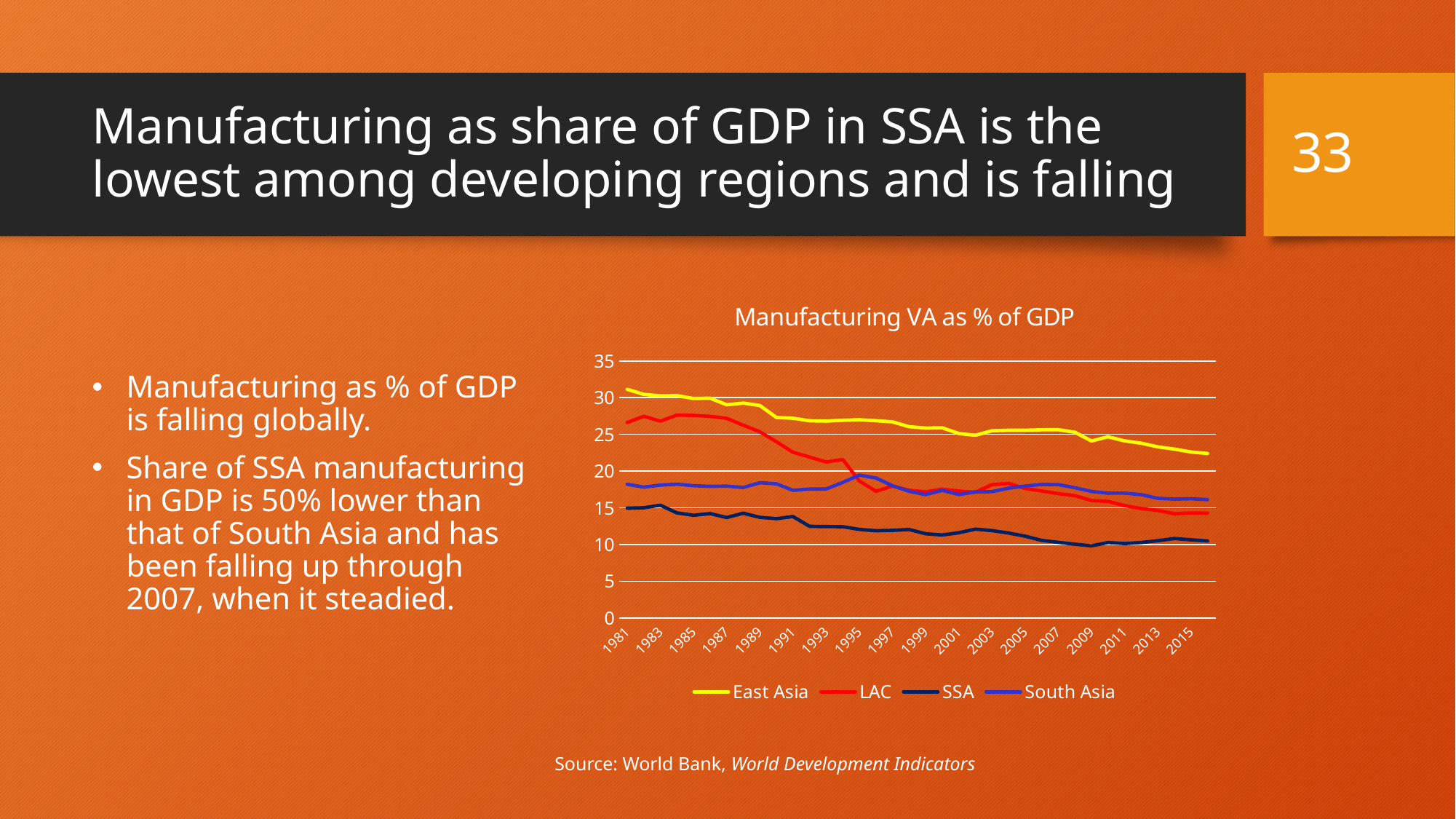
How many series does the legend list? 4 Is the value for East Asia in 1981 greater or less than 30? greater Which series has the highest values across the whole period? East Asia Which series has the lowest values across the whole period? SSA What kind of chart is shown on the slide? line chart In 2015, which is larger, the value for East Asia or the value for SSA? East Asia Does the LAC line rise or fall from 1981 to 2015? fall What colour is the East Asia line in the legend? yellow Does the East Asia line rise or fall from 1981 to 2015? fall Is the value for LAC in 1981 greater or less than 25? greater What is the title of the chart? Manufacturing VA as % of GDP Is the value for SSA in 2015 greater or less than 15? less